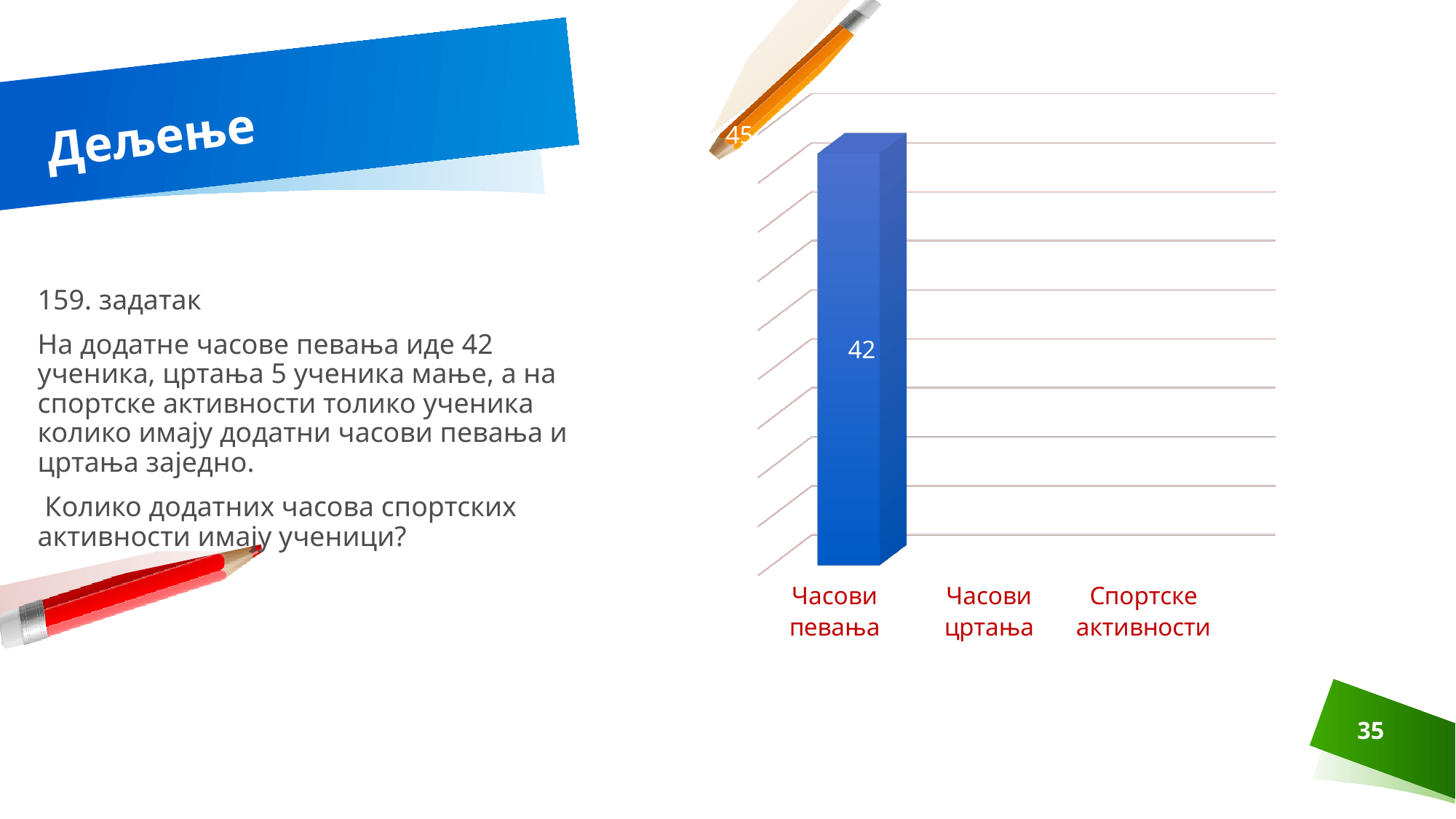
Is the value for Часови певања greater or less than 45? less What colour is the bar for Часови певања? blue Which category is the only one with a bar plotted in the chart? Часови певања What kind of chart is shown on the slide? bar chart What is the value shown for Часови певања? 42 How many categories are listed on the x axis of the chart? 3 What is the label of the third category on the x axis? Спортске активности